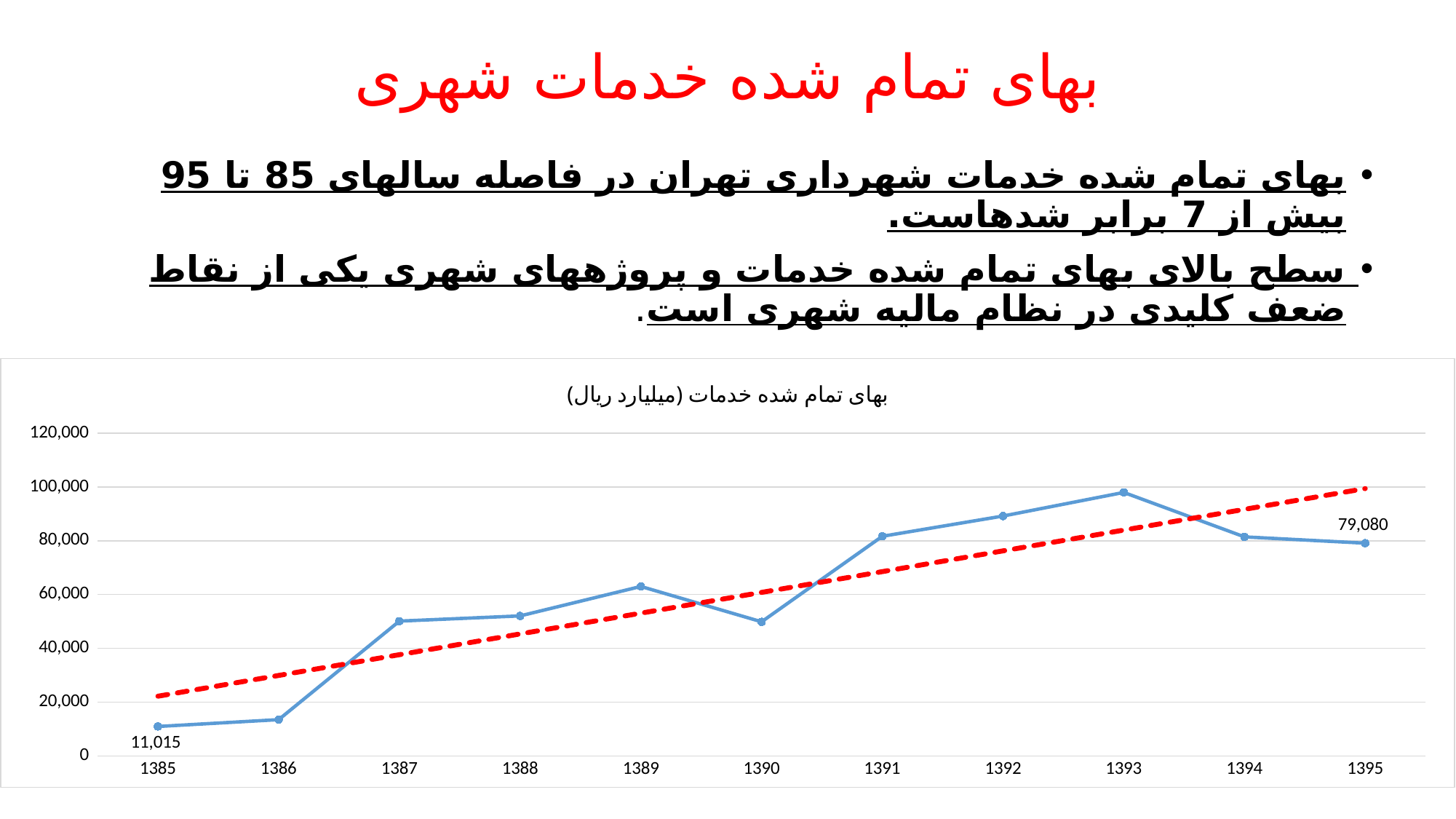
Is the value for 1393 greater or less than 80,000? greater What is the value for 1395 in the chart? 79,080 What is the difference between the values for 1395 and 1385? 68,065 Which year has the highest value in the chart? 1393 Do the values generally rise or fall from 1385 to 1393? rise Is the value for 1390 greater or less than 60,000? less Is the value for 1392 greater or less than 80,000? greater What is the value for 1385 in the chart? 11,015 Which is larger, the value for 1393 or the value for 1395? 1393 How many years are plotted on the x axis of the chart? 11 What kind of chart is shown on the slide? line chart